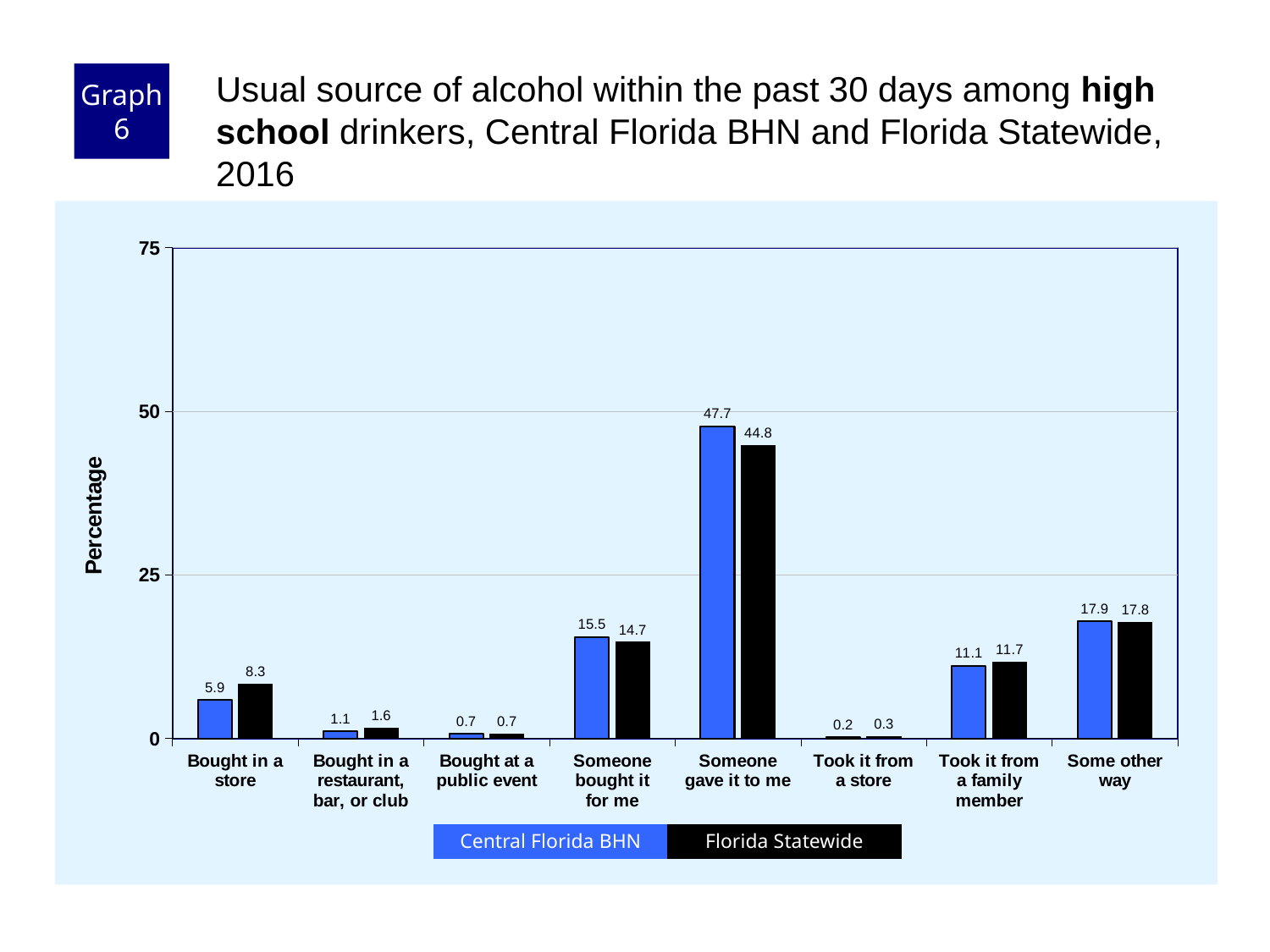
For "Bought in a store", which is larger: the Central Florida BHN value or the Florida Statewide value? Florida Statewide What is the Central Florida BHN value for "Someone gave it to me"? 47.7 How many categories are shown on the x axis? 8 Is the Central Florida BHN value for "Someone bought it for me" greater or less than 25? less Which category has the lowest Florida Statewide value? Took it from a store How many series does the legend list? 2 What kind of chart is shown on the slide? bar chart What is the Florida Statewide value for "Bought in a store"? 8.3 What is the label of the y axis? Percentage What is the Florida Statewide value for "Took it from a family member"? 11.7 What is the difference between the Central Florida BHN and Florida Statewide values for "Someone gave it to me"? 2.9 Which category has the highest Central Florida BHN value? Someone gave it to me